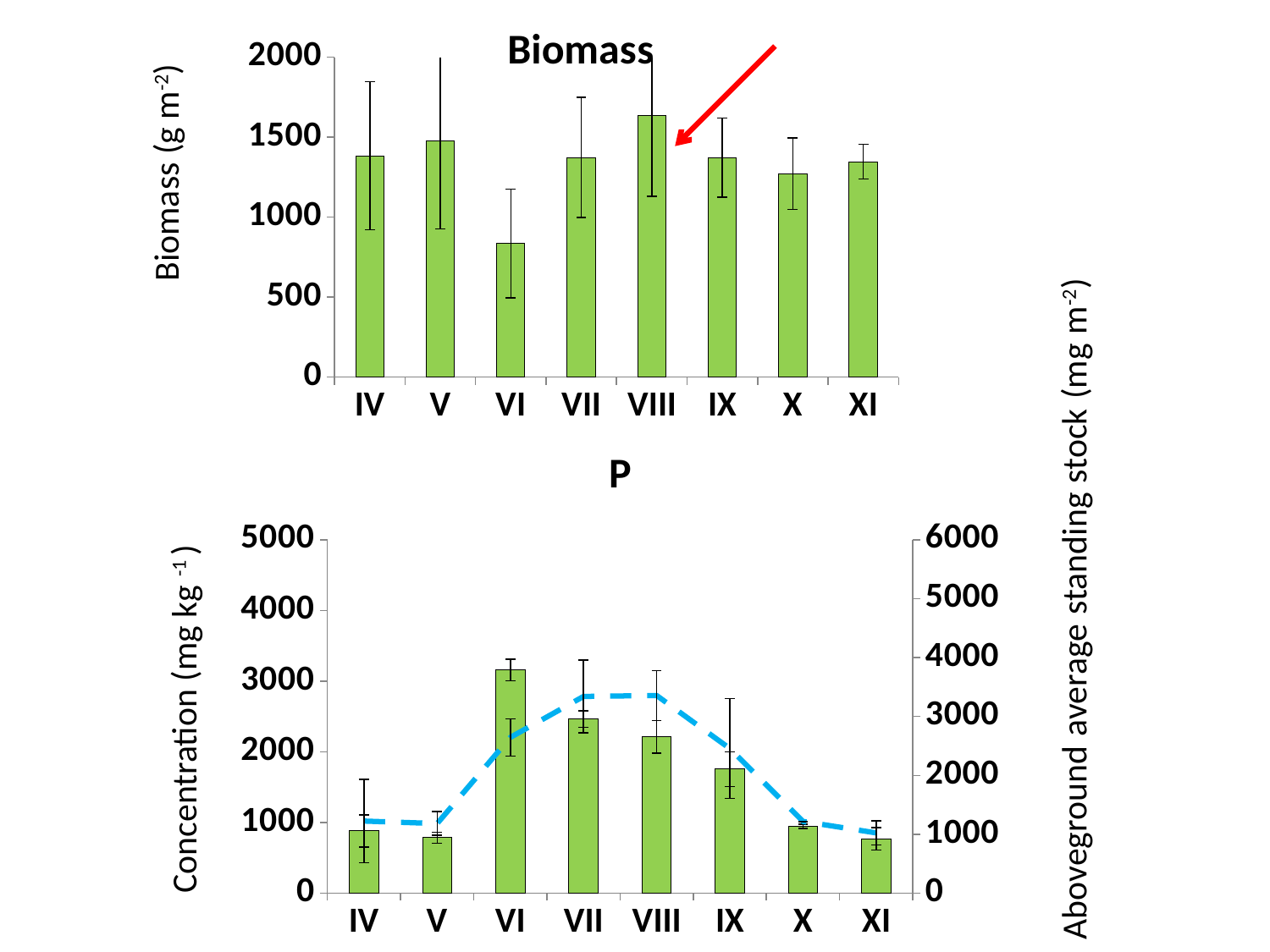
In the P chart, which has the larger concentration bar, VI or VII? VI In the P chart, is the concentration bar for VI greater or less than 3000? greater In the Biomass chart, is the value for X greater or less than 1500? less What kind of chart is the Biomass chart? bar chart In the P chart, what is the label of the right-hand y axis? Aboveground average standing stock (mg m-2) In the Biomass chart, which category has the highest biomass? VIII In the Biomass chart, how many categories are shown on the x axis? 8 In the Biomass chart, which category has the lowest biomass? VI In the Biomass chart, is the value for VIII greater or less than 1500? greater In the P chart, which category has the highest concentration bar? VI